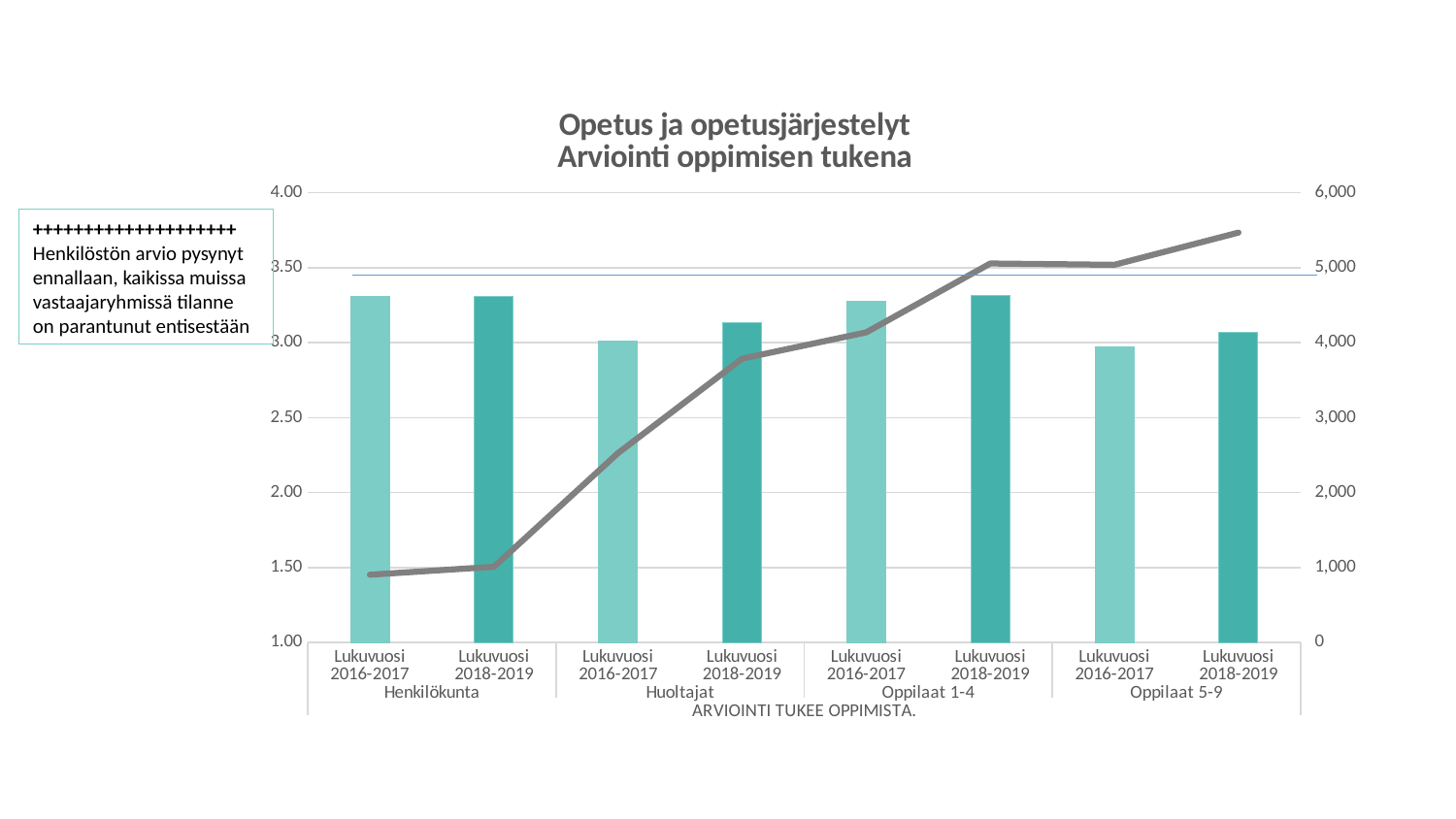
Is the bar for Oppilaat 5-9 Lukuvuosi 2016-2017 greater or less than 2.50? greater How many respondent groups are shown along the x axis? 4 What kind of chart is shown on the slide? A bar chart combined with a line Is the bar for Huoltajat Lukuvuosi 2016-2017 greater or less than 3.50? less How many bars are plotted in the chart? 8 Is the bar for Oppilaat 1-4 Lukuvuosi 2018-2019 greater or less than 3.50? less For Oppilaat 5-9, which bar is taller: Lukuvuosi 2016-2017 or Lukuvuosi 2018-2019? Lukuvuosi 2018-2019 Does the grey line rise or fall from left to right across the chart? rises For Huoltajat, which bar is taller: Lukuvuosi 2016-2017 or Lukuvuosi 2018-2019? Lukuvuosi 2018-2019 What is the title of the chart? Opetus ja opetusjärjestelyt Arviointi oppimisen tukena